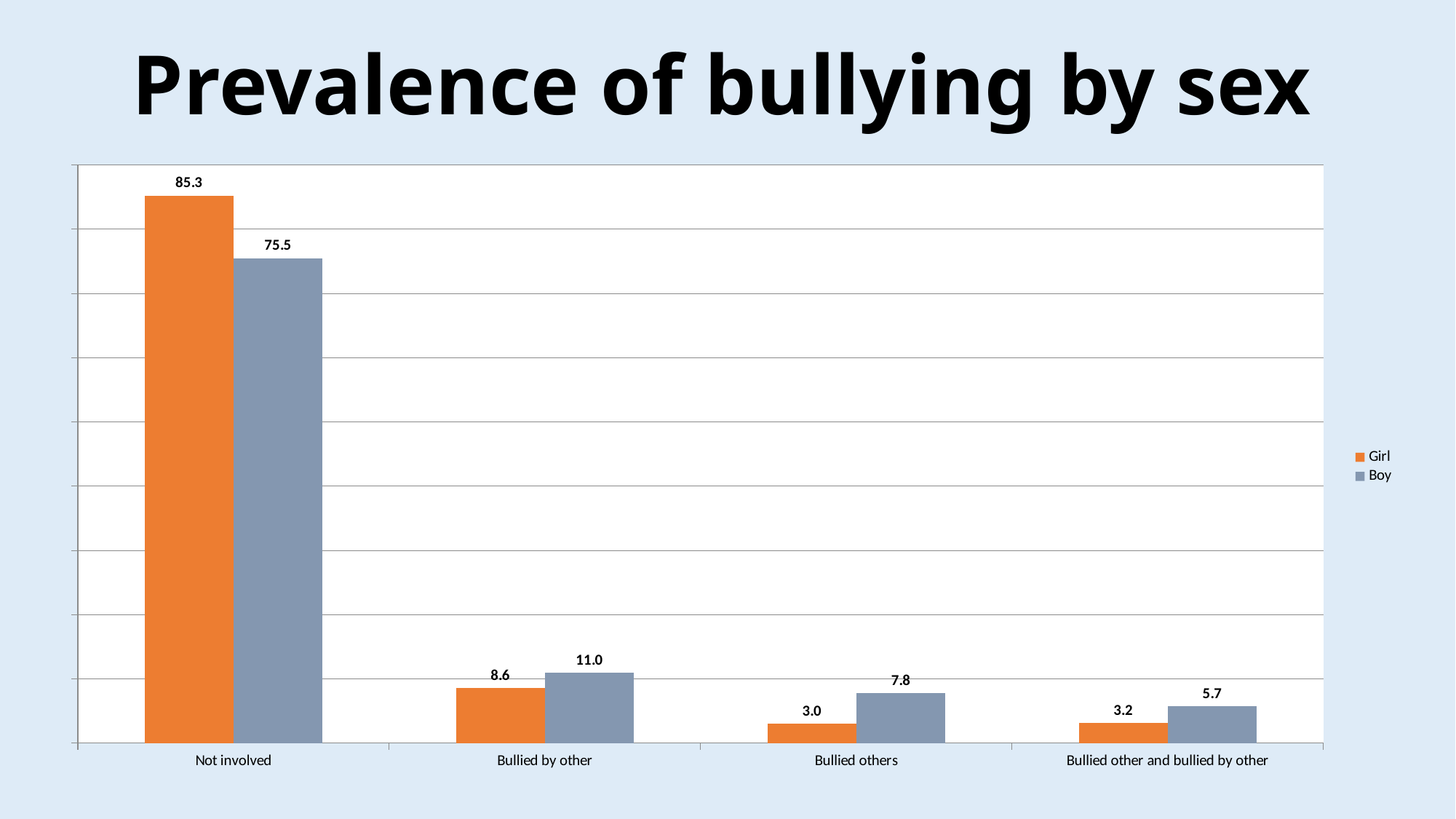
What is the value for Boy in the Bullied by other category? 11.0 Which category has the lowest value for Girl? Bullied others Which category has the highest value for Boy? Not involved What is the difference between the Girl and Boy values in the Not involved category? 9.8 What is the value for Boy in the Bullied other and bullied by other category? 5.7 What kind of chart is shown on the slide? Bar chart What is the value for Girl in the Not involved category? 85.3 How many categories are shown on the x axis? 4 What is the title of the slide? Prevalence of bullying by sex What is the value for Girl in the Bullied others category? 3.0 In the Bullied others category, which is larger, the Girl value or the Boy value? Boy How many series does the legend list? 2